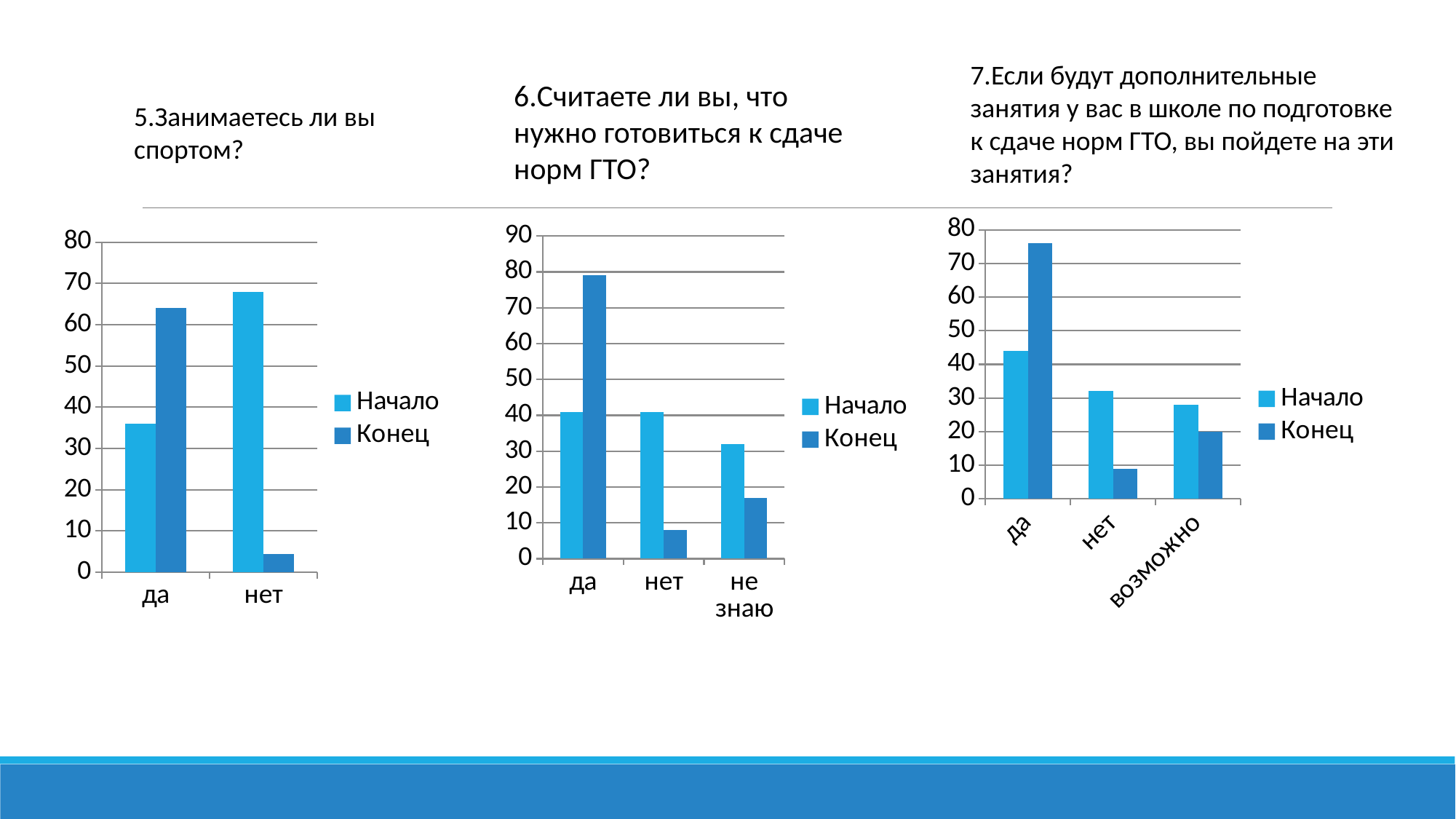
In the left chart (5.Занимаетесь ли вы спортом?), how many series does the legend list? 2 In the middle chart (6.Считаете ли вы, что нужно готовиться к сдаче норм ГТО?), is the value for Конец at да greater or less than 70? greater In the right chart (7.Если будут дополнительные занятия...), which category has the lowest Начало value? возможно In the middle chart (6.Считаете ли вы, что нужно готовиться к сдаче норм ГТО?), which category has the lowest Конец value? нет In the middle chart (6.Считаете ли вы, что нужно готовиться к сдаче норм ГТО?), how many categories are shown on the x axis? 3 In the left chart (5.Занимаетесь ли вы спортом?), which is larger for да: Начало or Конец? Конец In the right chart (7.Если будут дополнительные занятия...), which is larger for возможно: Начало or Конец? Начало In the left chart (5.Занимаетесь ли вы спортом?), is the value for Конец at нет greater or less than 10? less In the right chart (7.Если будут дополнительные занятия...), is the value for Конец at да greater or less than 70? greater In the middle chart (6.Считаете ли вы, что нужно готовиться к сдаче норм ГТО?), which category has the highest Конец value? да What kind of chart is the right chart (7.Если будут дополнительные занятия...)? bar chart